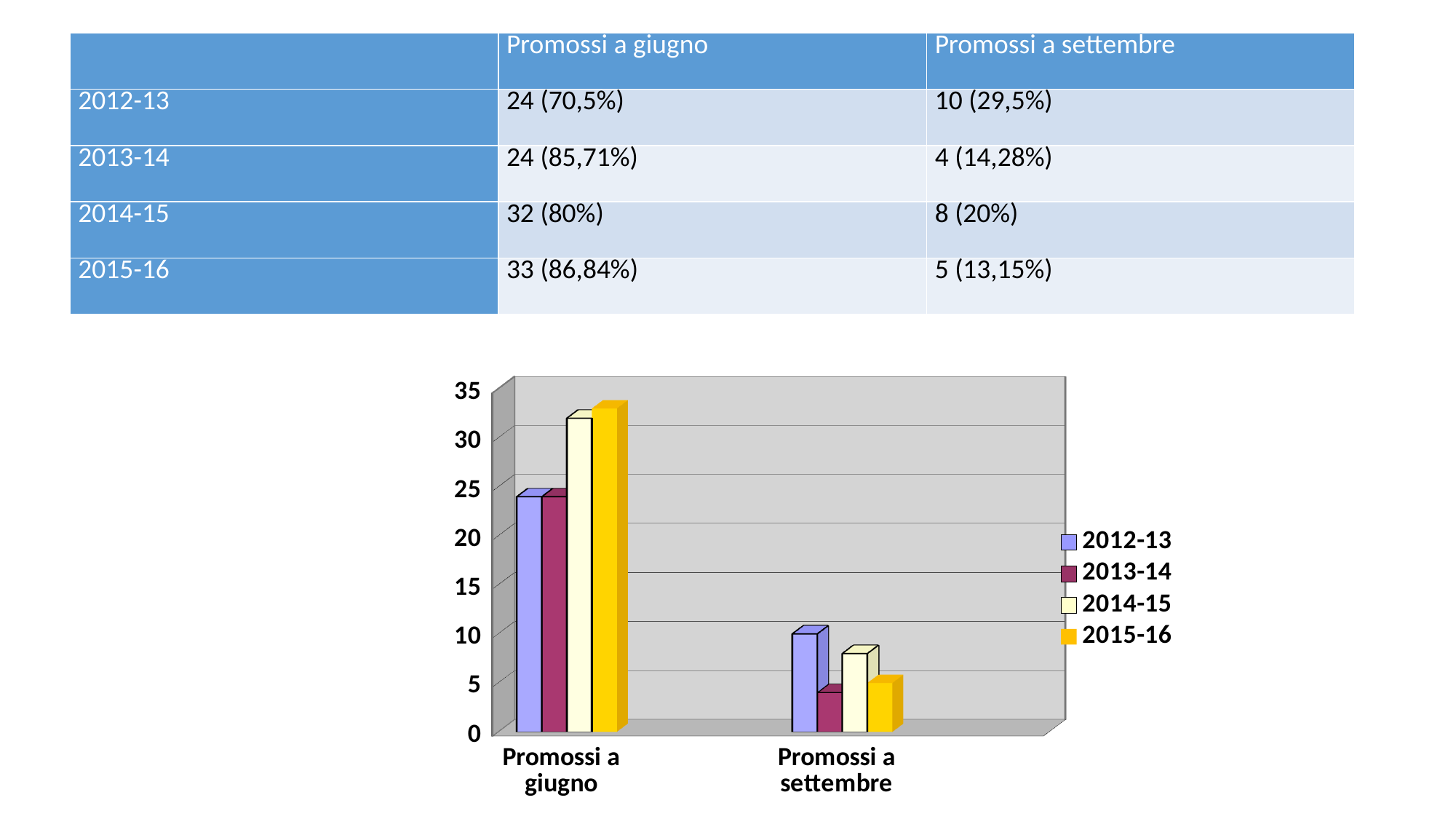
Which series has the shortest bar for Promossi a settembre? 2013-14 Which series has the tallest bar for Promossi a giugno? 2015-16 Which is larger: the 2012-13 bar or the 2014-15 bar for Promossi a settembre? 2012-13 What kind of chart is shown on the slide? bar chart What colour is the 2015-16 series in the chart? yellow Is the value for 2013-14 in Promossi a settembre greater or less than 5? less Is the value for 2014-15 in Promossi a giugno greater or less than 30? greater How many series does the chart legend list? 4 What is the value for 2015-16 in Promossi a giugno? 33 How many categories are shown on the x axis of the chart? 2 Is the value for 2012-13 in Promossi a giugno greater or less than 25? less What is the value for 2014-15 in Promossi a settembre? 8